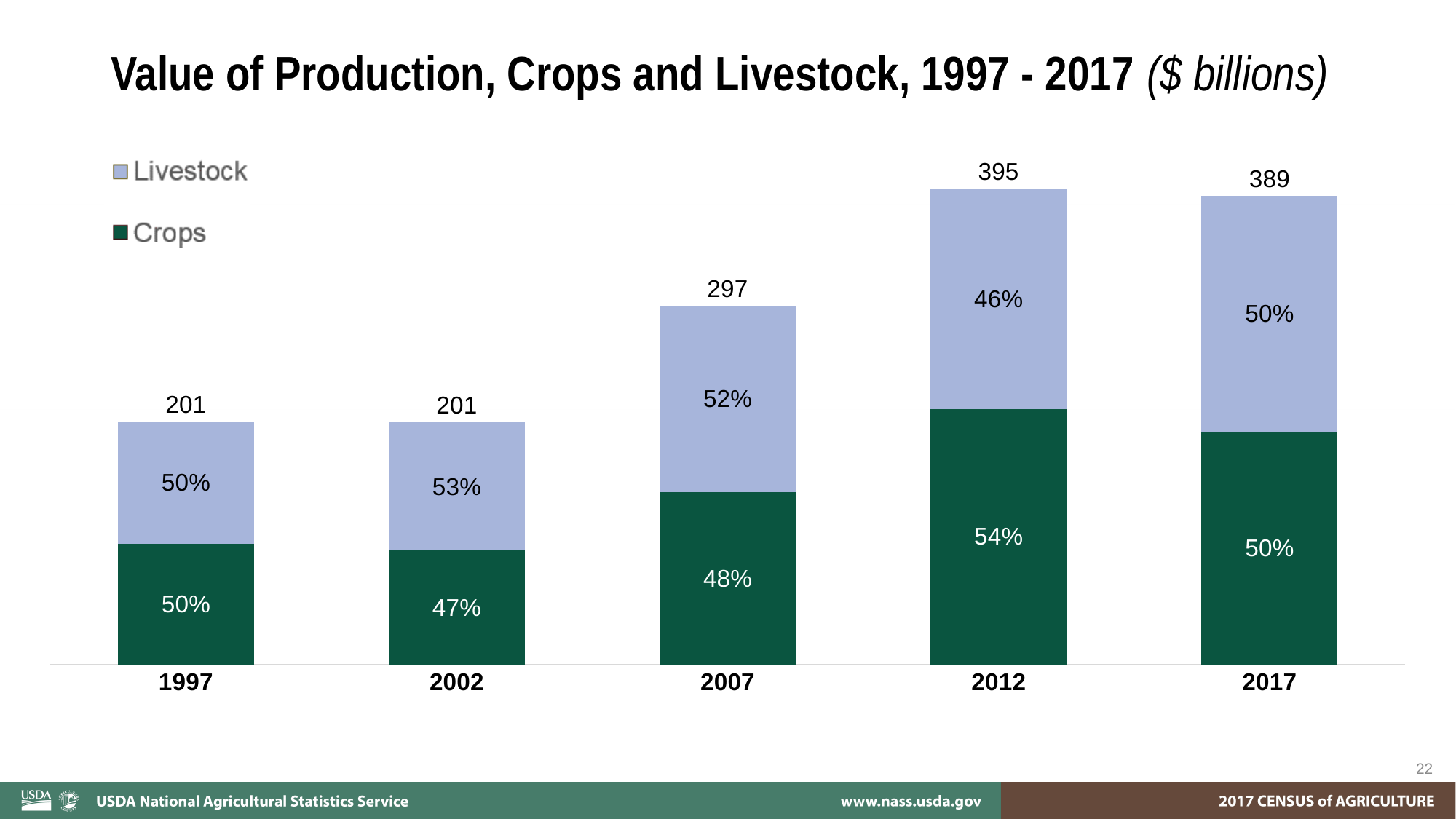
What is the total value of production shown for 2012? 395 What percentage share does Crops have in 2012? 54% What kind of chart is shown on the slide? Stacked bar chart How many years are shown on the x axis? 5 What percentage share does Livestock have in 2007? 52% Which year has the highest total value of production? 2012 What percentage share does Crops have in 2002? 47% What is the difference between the total value of production in 2012 and in 2017? 6 What is the total value of production shown for 2017? 389 What is the difference between the total value of production in 2007 and in 2002? 96 How many series does the legend list? 2 Is the total value of production larger in 2007 or in 2017? 2017